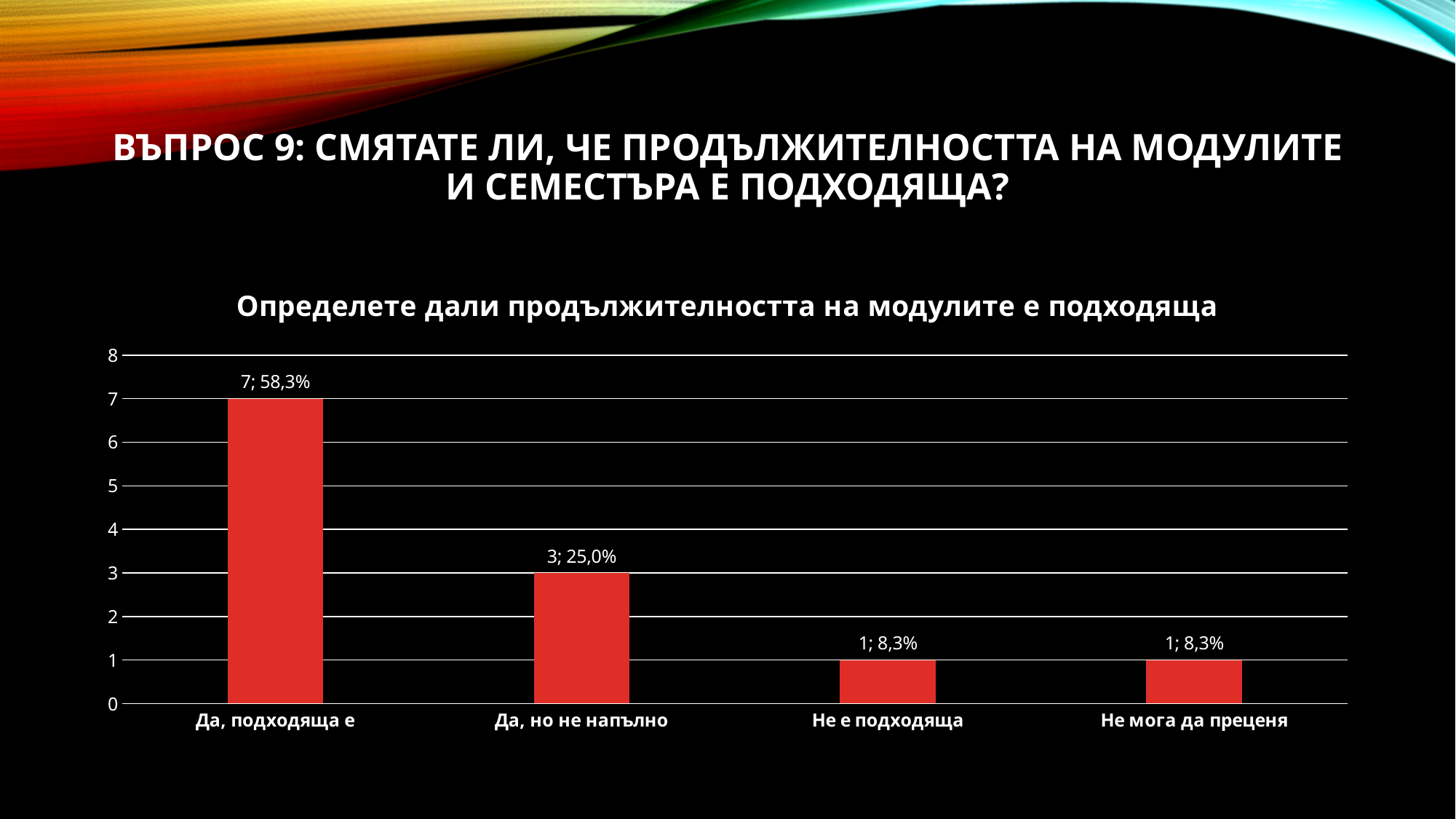
Is the value for "Да, подходяща е" greater or less than 5? greater What is the value for "Да, но не напълно"? 3; 25,0% What percentage is shown for "Не мога да преценя"? 8,3% What is the value for "Не е подходяща"? 1; 8,3% What is the difference in count between "Да, подходяща е" and "Да, но не напълно"? 4 What is the title of the chart? Определете дали продължителността на модулите е подходяща What kind of chart is shown? bar chart What is the value for "Да, подходяща е"? 7; 58,3% Which is larger, the value for "Да, но не напълно" or the value for "Не е подходяща"? Да, но не напълно Do the values rise or fall from left to right along the x axis? fall How many categories are shown on the x axis? 4 Which category has the highest value? Да, подходяща е